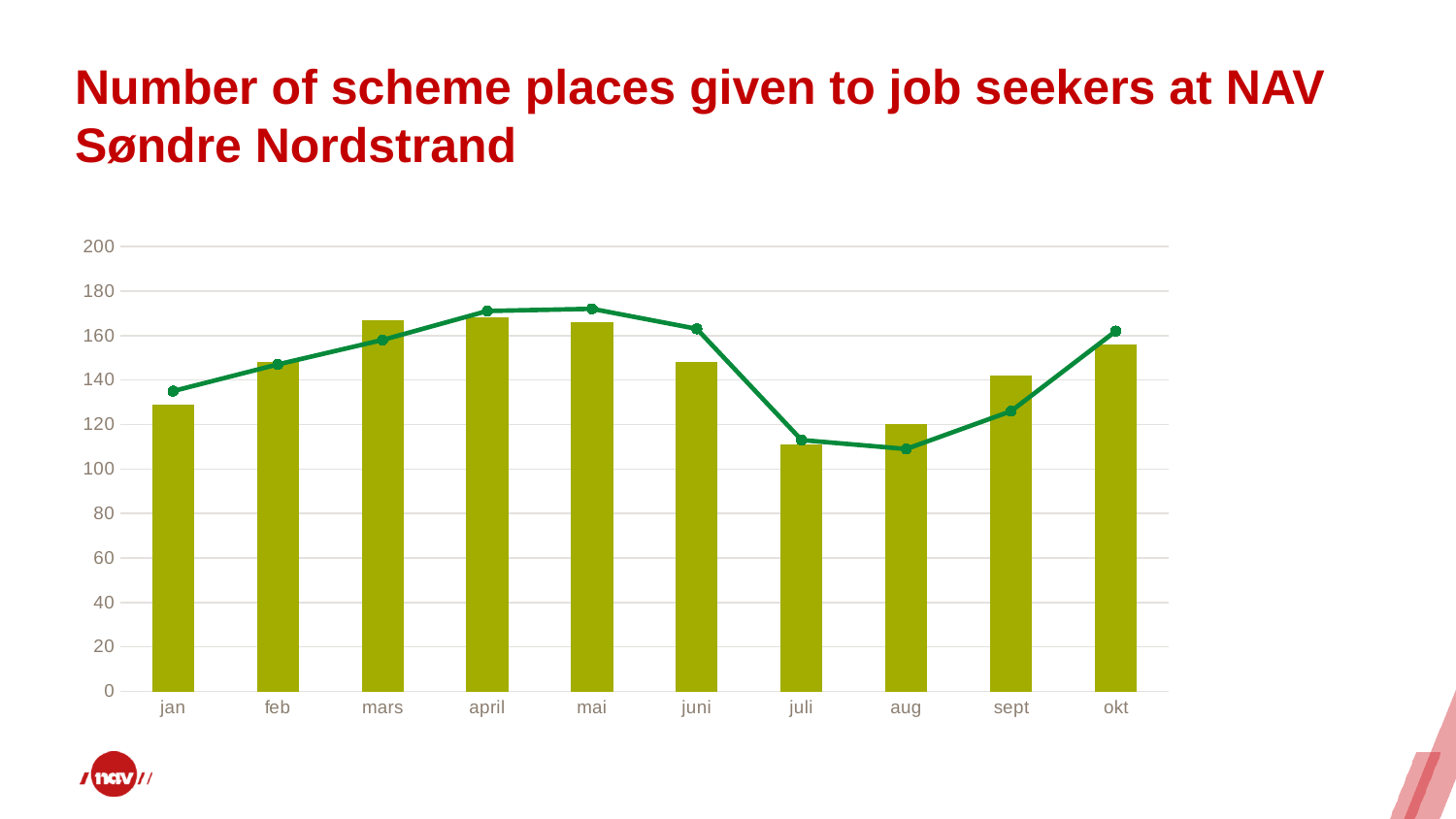
Is the bar value for juli greater or less than 120? less How many months are shown on the x axis of the chart? 10 Is the bar value for aug greater or less than 140? less Is the bar value for jan greater or less than 140? less Which month has the lowest bar in the chart? juli What kind of chart is shown on the slide? A bar chart combined with a line Do the bar values rise or fall from mai to aug? fall What is the title of the chart on the slide? Number of scheme places given to job seekers at NAV Søndre Nordstrand Which has the taller bar, okt or jan? okt Which has the taller bar, sept or aug? sept